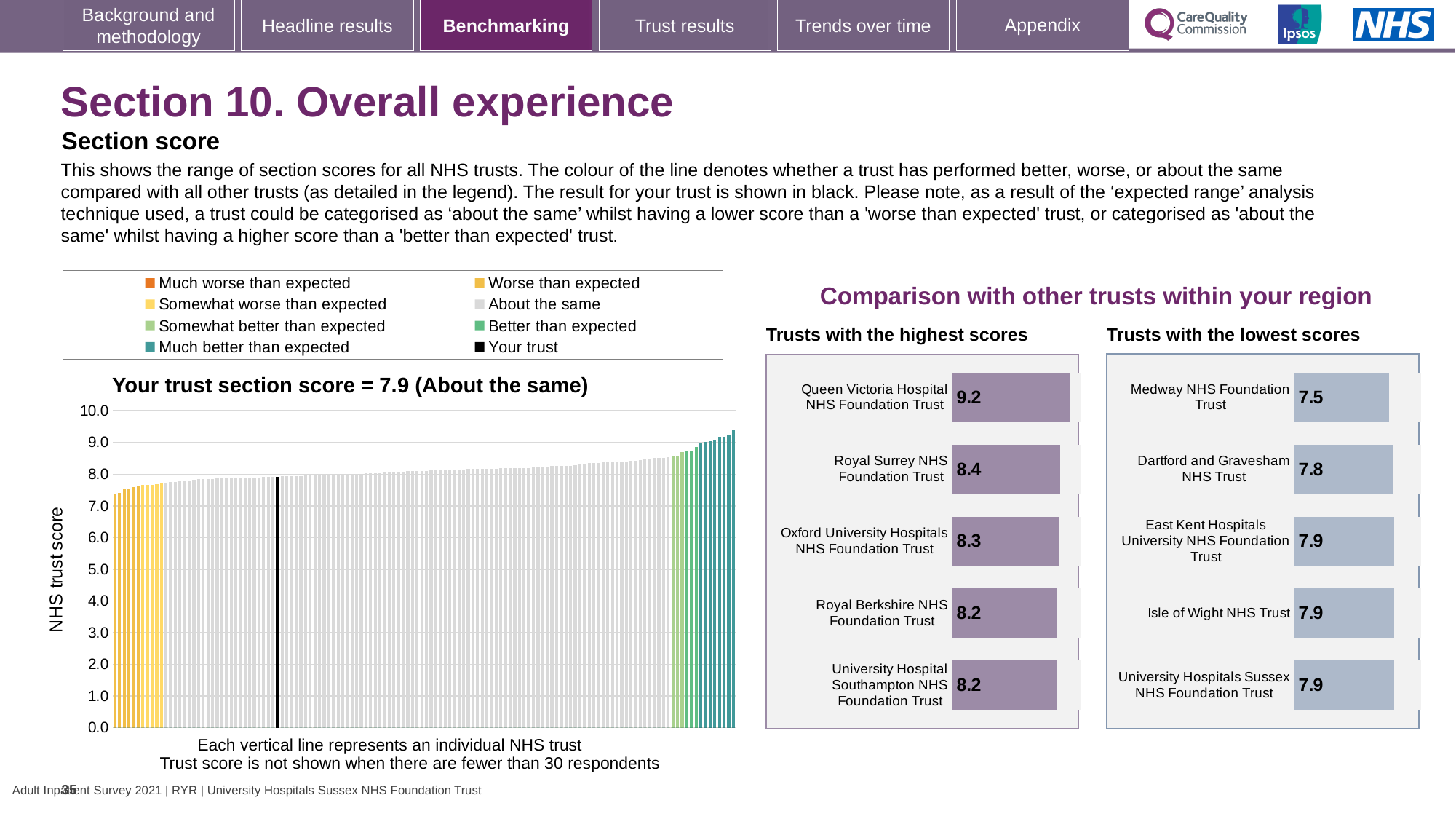
What kind of chart is the main chart on the left showing all NHS trusts? Bar chart In the 'Trusts with the lowest scores' chart, what is the score for Dartford and Gravesham NHS Trust? 7.8 In the 'Trusts with the highest scores' chart, which has the larger score: Royal Surrey NHS Foundation Trust or Royal Berkshire NHS Foundation Trust? Royal Surrey NHS Foundation Trust In the 'Trusts with the highest scores' chart, which trust has the highest score? Queen Victoria Hospital NHS Foundation Trust In the 'Trusts with the highest scores' chart, what is the score for Oxford University Hospitals NHS Foundation Trust? 8.3 In the 'Trusts with the highest scores' chart, what is the score for Queen Victoria Hospital NHS Foundation Trust? 9.2 How many trusts are shown in the 'Trusts with the lowest scores' chart? 5 In the 'Trusts with the lowest scores' chart, what is the score for Medway NHS Foundation Trust? 7.5 In the 'Trusts with the lowest scores' chart, what is the difference between the scores of Isle of Wight NHS Trust and Medway NHS Foundation Trust? 0.4 In the 'Trusts with the highest scores' chart, what is the difference between the scores of Queen Victoria Hospital NHS Foundation Trust and Royal Surrey NHS Foundation Trust? 0.8 In the 'Trusts with the lowest scores' chart, which trust has the lowest score? Medway NHS Foundation Trust According to the title of the main chart on the left, what is your trust's section score? 7.9 (About the same)